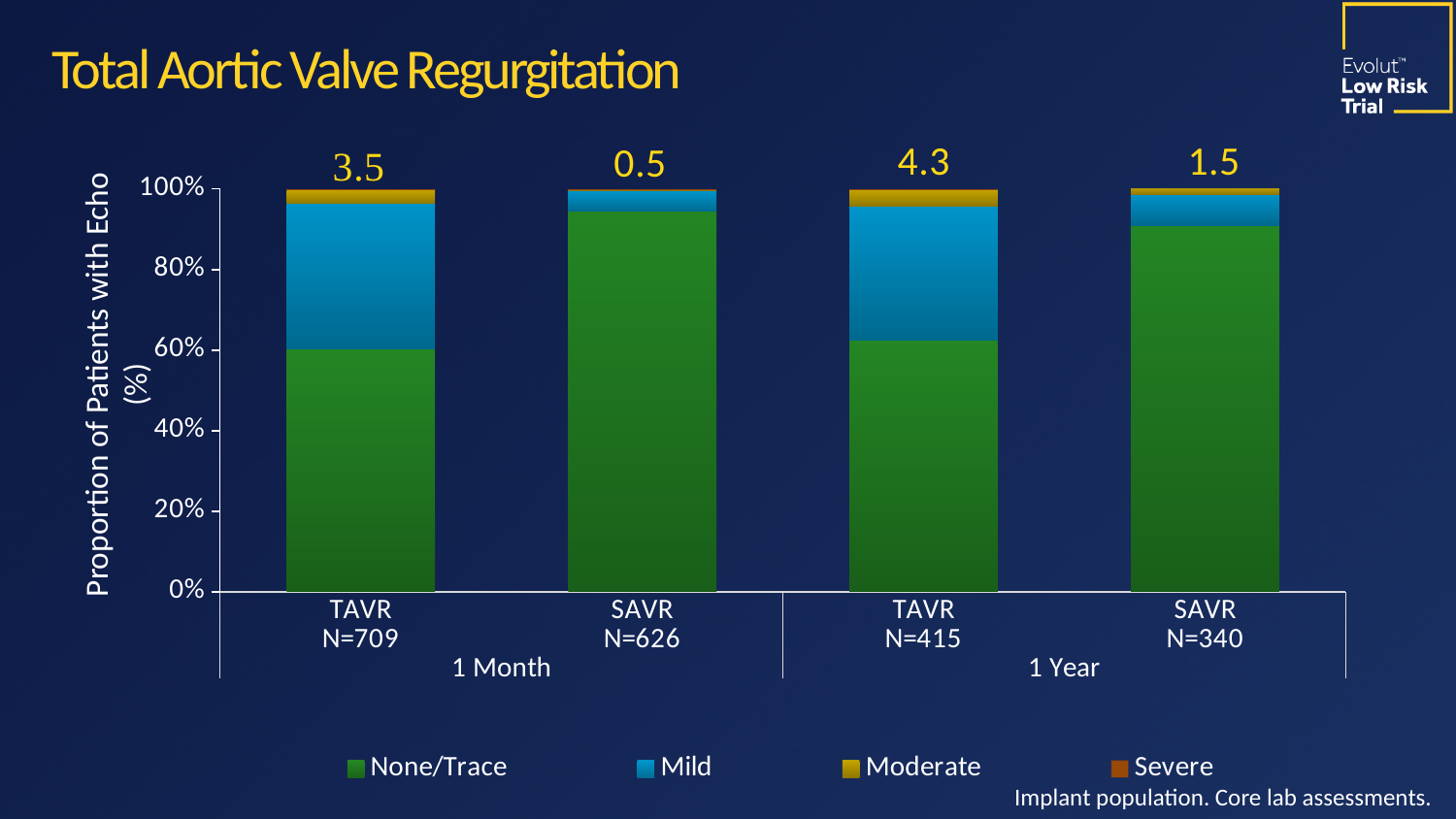
Which bar has the lowest value printed above it? SAVR N=626 (1 Month) How many series does the legend list? 4 What is the difference between the values printed above the TAVR bars at 1 Year and at 1 Month? 0.8 Is the None/Trace proportion for SAVR at 1 Month greater or less than 80%? greater What value is printed above the TAVR N=415 bar at 1 Year? 4.3 What value is printed above the SAVR N=340 bar at 1 Year? 1.5 What value is printed above the TAVR N=709 bar at 1 Month? 3.5 Which has a larger Mild segment at 1 Month, TAVR or SAVR? TAVR Which bar has the highest value printed above it? TAVR N=415 (1 Year) What kind of chart is shown on the slide? Stacked bar chart What value is printed above the SAVR N=626 bar at 1 Month? 0.5 Is the None/Trace proportion for TAVR at 1 Year greater or less than 80%? less